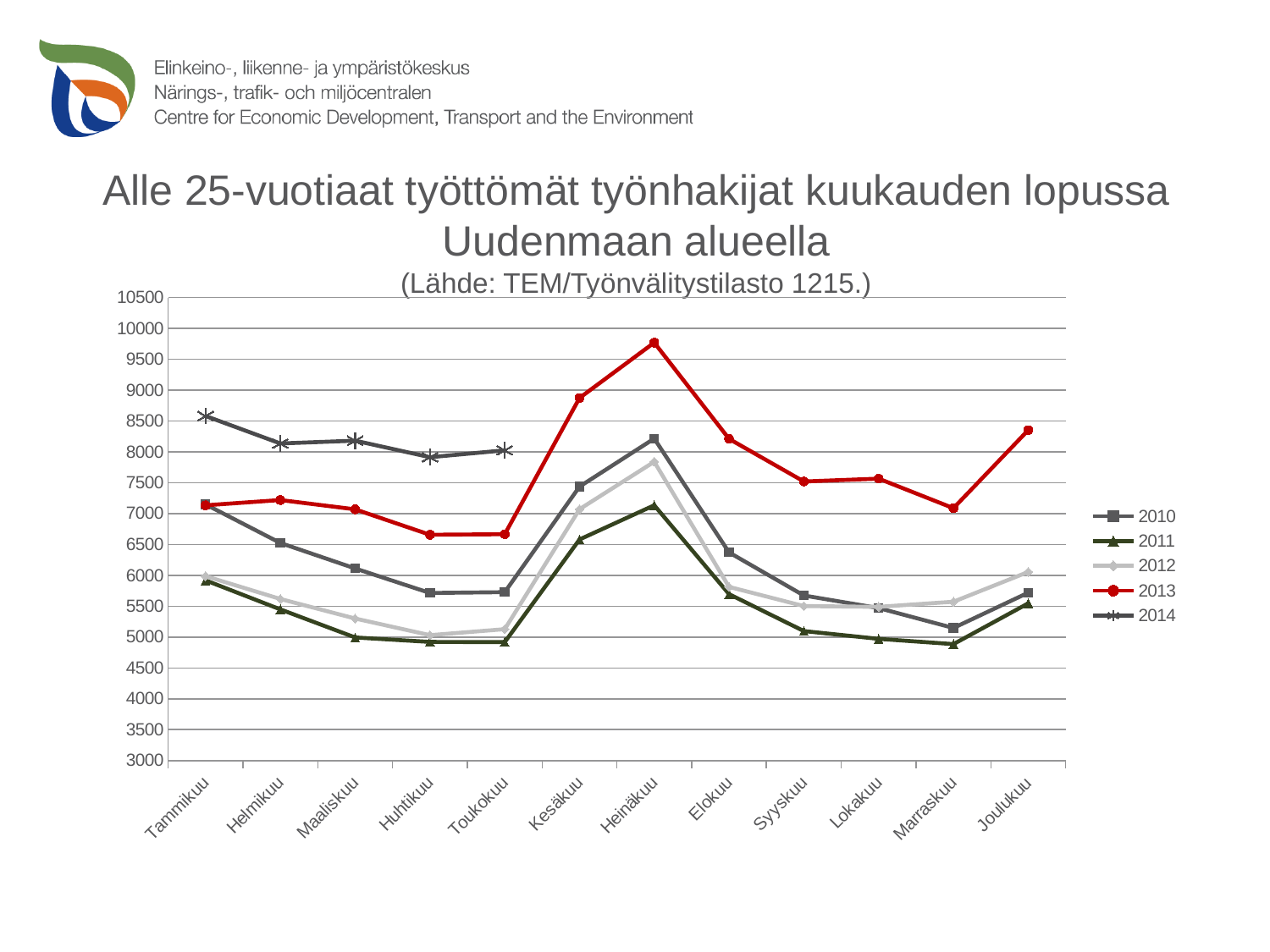
What kind of chart is shown on the slide? line chart In which month does the 2010 series reach its lowest value? Marraskuu Does the 2014 series rise or fall from Tammikuu to Huhtikuu? fall How many months are shown on the x axis? 12 Is the value for 2013 in Heinäkuu greater or less than 9500? greater In Elokuu, which series has the larger value, 2013 or 2010? 2013 Which series is drawn in red? 2013 Which series has the highest value in Tammikuu? 2014 How many series does the legend list? 5 Is the value for 2014 in Tammikuu greater or less than 8000? greater In which month does the 2013 series reach its highest value? Heinäkuu Is the value for 2012 in Huhtikuu greater or less than 5500? less